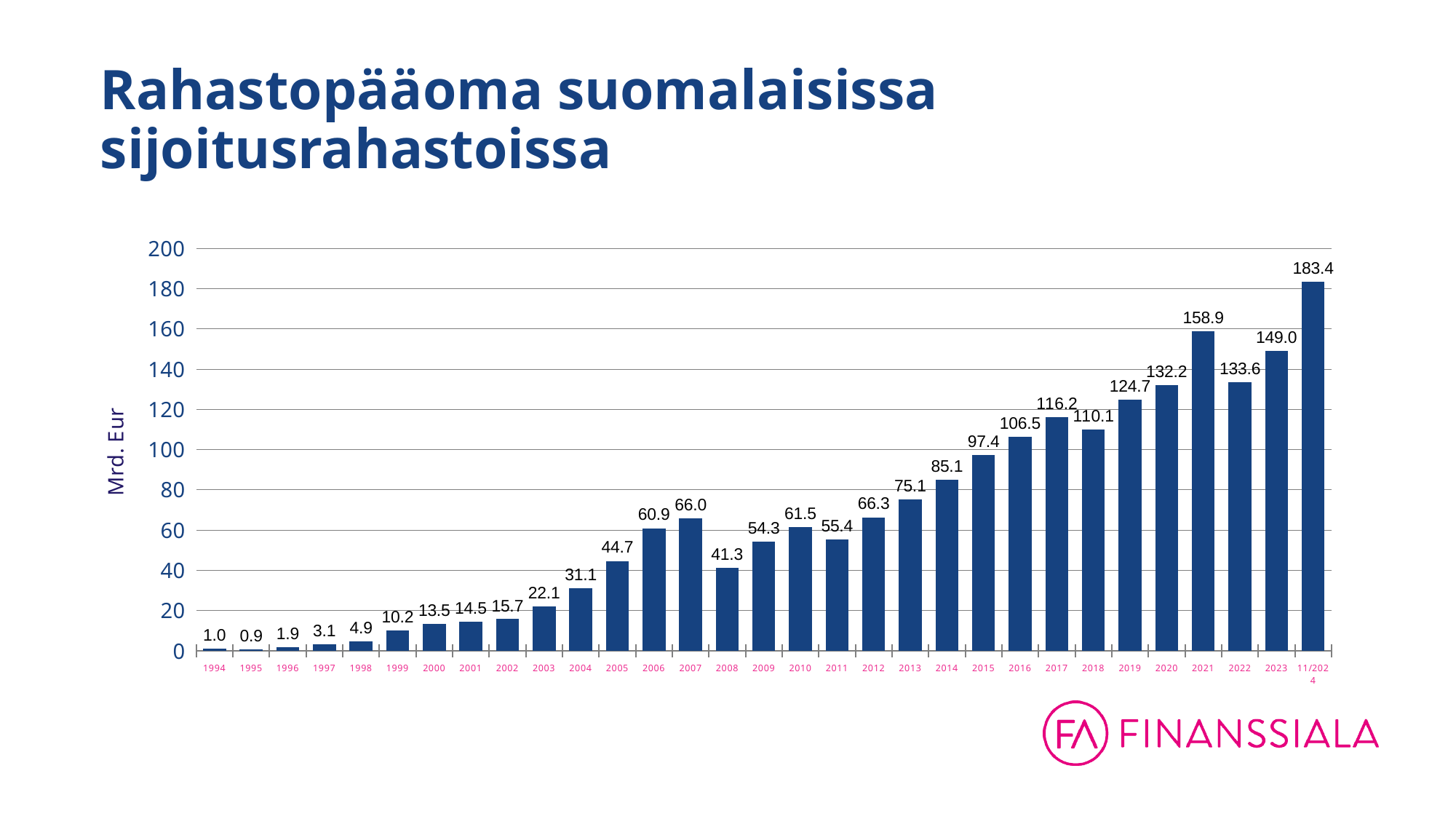
Which category has the highest value? 11/2024 What is the label on the vertical axis? Mrd. Eur Which is larger, the value for 2007 or the value for 2010? 2007 Do the values generally rise or fall from 1994 to 11/2024? rise What is the title of the chart? Rahastopääoma suomalaisissa sijoitusrahastoissa How many bars are shown in the chart? 31 What is the difference between the values for 2023 and 2022? 15.4 What is the value for 2008? 41.3 Which year has the lowest value? 1995 What is the value for 2021? 158.9 What kind of chart is shown on the slide? bar chart What is the value for 11/2024? 183.4